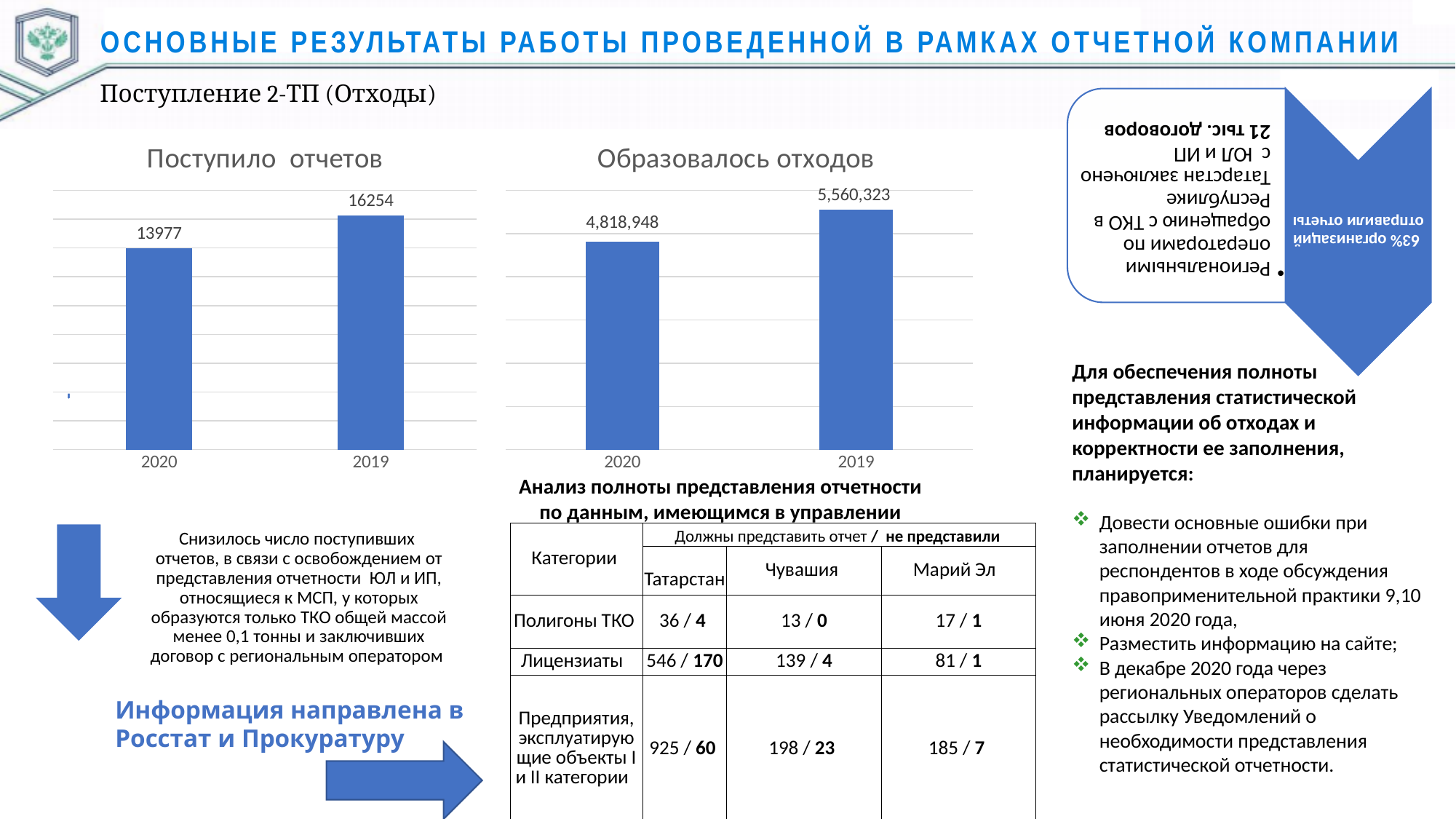
How many bars are shown in the chart titled "Поступило отчетов"? 2 In the chart titled "Поступило отчетов", what is the value for 2019? 16254 In the chart titled "Поступило отчетов", what is the difference between the 2019 and 2020 values? 2277 In the chart titled "Образовалось отходов", which year has the lower value? 2020 In the chart titled "Образовалось отходов", what is the difference between the 2019 and 2020 values? 741,375 In the chart titled "Образовалось отходов", is the value for 2019 larger or smaller than the value for 2020? larger What is the title of the left chart on the slide? Поступило отчетов What type of chart is the chart titled "Образовалось отходов"? bar chart In the chart titled "Образовалось отходов", what is the value for 2019? 5,560,323 In the chart titled "Образовалось отходов", what is the value for 2020? 4,818,948 In the chart titled "Поступило отчетов", what is the value for 2020? 13977 In the chart titled "Поступило отчетов", which year has the higher value? 2019